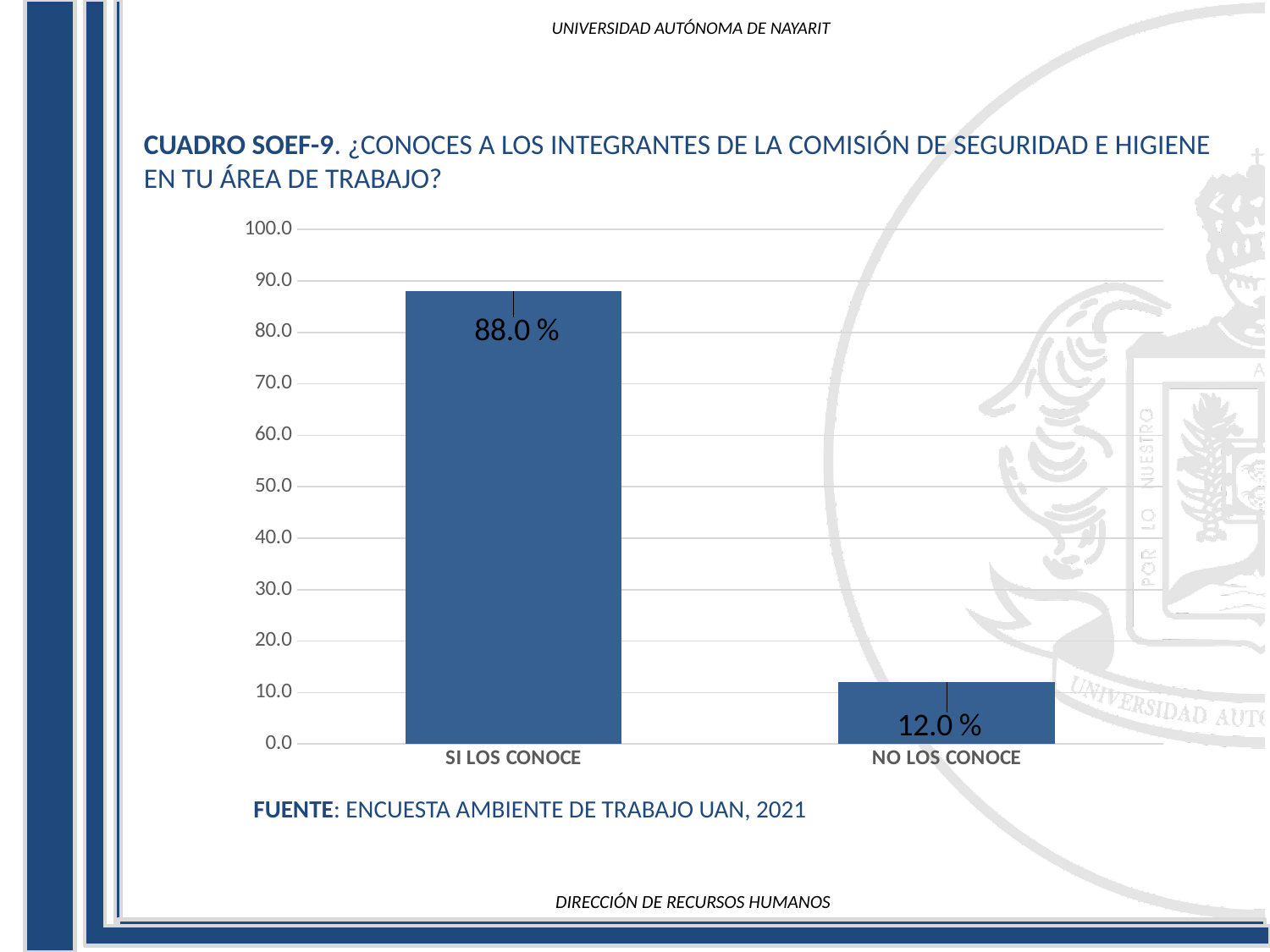
What is the value for NO LOS CONOCE? 12.0 % Which category has the lowest value? NO LOS CONOCE Is the value for SI LOS CONOCE greater or less than 80.0? greater What kind of chart is shown on the slide? Bar chart What is the highest value shown on the y axis? 100.0 What source is cited below the chart? ENCUESTA AMBIENTE DE TRABAJO UAN, 2021 What is the difference between the values for SI LOS CONOCE and NO LOS CONOCE? 76.0 % How many categories are shown on the x axis? 2 Which category has the highest value? SI LOS CONOCE What is the value for SI LOS CONOCE? 88.0 % Which is larger, the value for SI LOS CONOCE or NO LOS CONOCE? SI LOS CONOCE Is the value for NO LOS CONOCE greater or less than 20.0? less